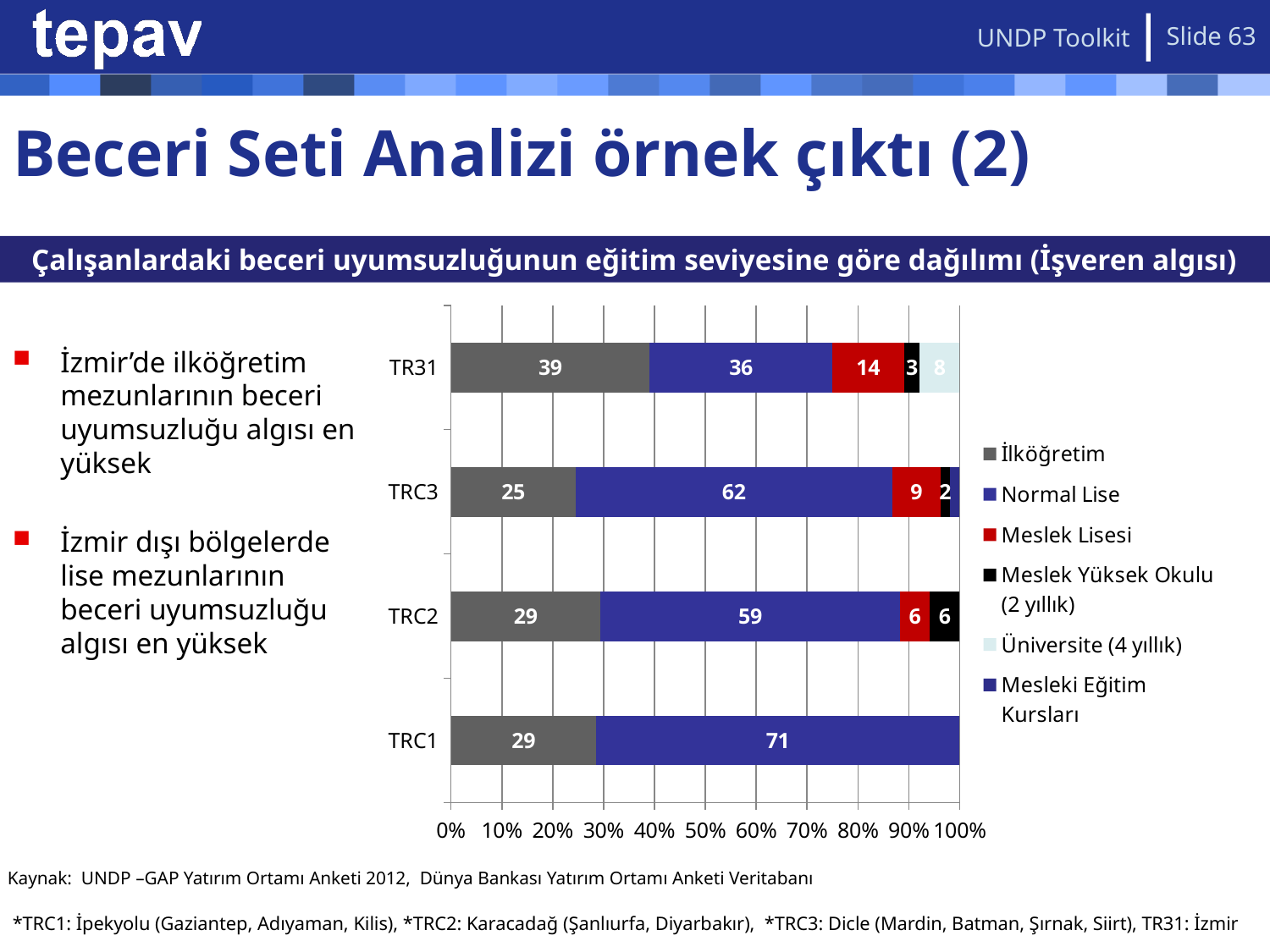
How many series does the legend list? 6 What is the Normal Lise value for TRC3? 62 What type of chart is shown on the slide? Stacked bar chart Which legend entry is shown in red? Meslek Lisesi What is the difference between the Normal Lise values for TRC1 and TRC2? 12 What is the Normal Lise value for TRC1? 71 How many regions (categories) are plotted on the chart? 4 Which region has the highest İlköğretim value? TR31 Which is larger, the Meslek Lisesi value for TRC3 or for TRC2? TRC3 What is the Meslek Lisesi value for TR31? 14 What is the İlköğretim value for TR31? 39 Which region has the lowest Normal Lise value? TR31